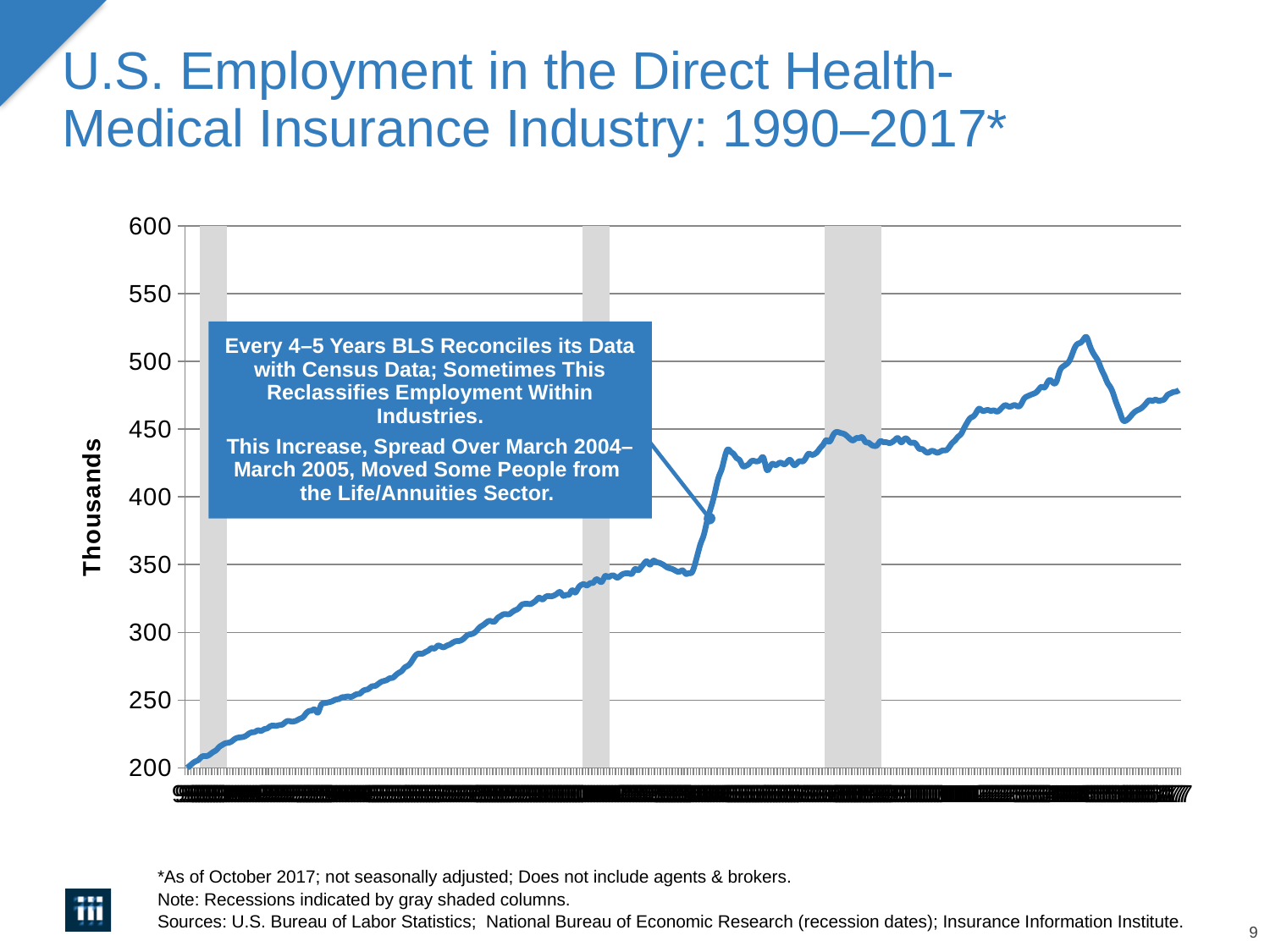
Overall, do the values rise or fall from the left to the right of the chart? rise Is the value at the right-hand end of the line greater or less than 500? less How many gray shaded recession columns are shown on the chart? 3 Is the highest point reached by the line greater or less than 500? greater What is the highest value shown on the vertical axis? 600 Which is larger, the value at the start of the line or the value at the end of the line? the value at the end What kind of chart is shown on the slide? line chart Is the value at the right-hand end of the line greater or less than 450? greater What is the title of the chart on the slide? U.S. Employment in the Direct Health-Medical Insurance Industry: 1990–2017* What is the label on the vertical axis of the chart? Thousands